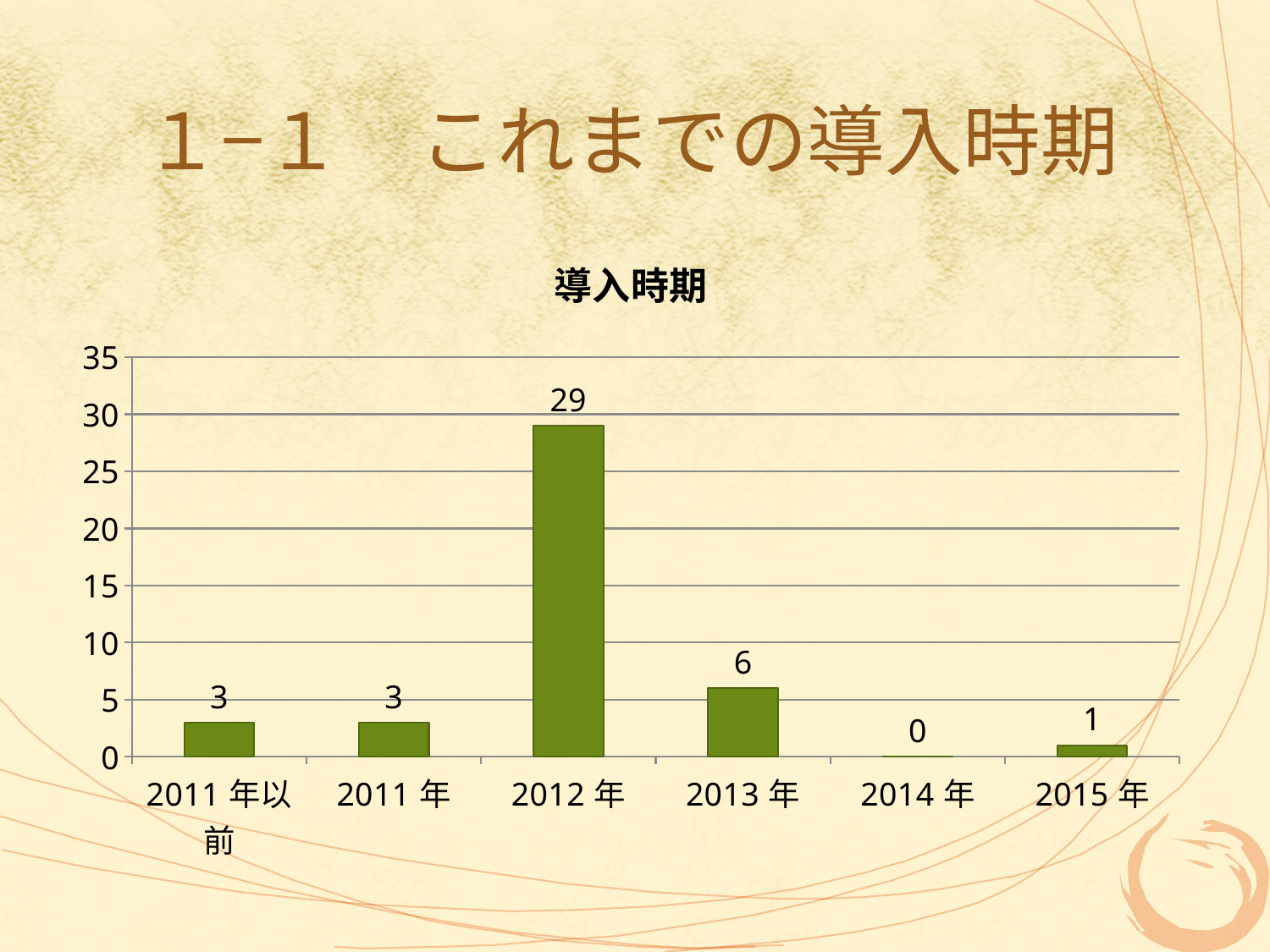
What is the value for 2014 年? 0 Which category has the lowest value? 2014 年 What kind of chart is shown on the slide? bar chart What is the title of the chart? 導入時期 How many categories are shown on the x axis? 6 What is the difference between the values for 2012 年 and 2013 年? 23 Is the value for 2012 年 greater or less than 25? greater Which category has the highest value? 2012 年 What is the value for 2015 年? 1 What is the value for 2013 年? 6 Which is larger, the value for 2013 年 or the value for 2015 年? 2013 年 What is the value for 2012 年? 29